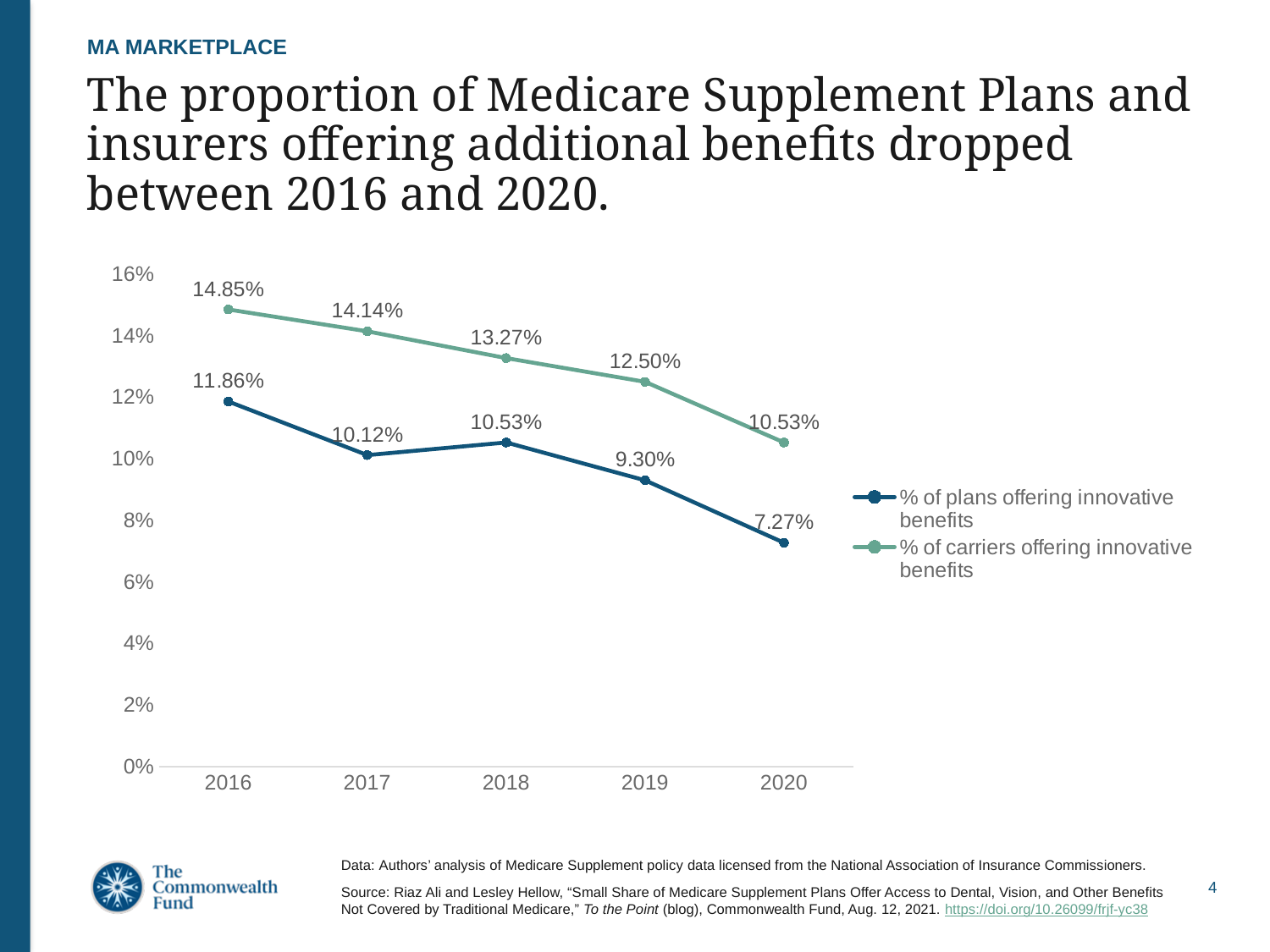
What percentage of plans offered innovative benefits in 2020? 7.27% Which was larger in 2018: the % of plans or the % of carriers offering innovative benefits? % of carriers offering innovative benefits How many years are shown on the x axis? 5 By how much did the % of plans offering innovative benefits fall from 2016 to 2020? 4.59% How many series does the legend list? 2 What kind of chart is shown on the slide? Line chart In which year was the % of carriers offering innovative benefits highest? 2016 What is the difference between the % of carriers and the % of plans offering innovative benefits in 2020? 3.26% What percentage of carriers offered innovative benefits in 2019? 12.50% What percentage of plans offered innovative benefits in 2016? 11.86% Does the % of carriers offering innovative benefits rise or fall from 2016 to 2020? Fall In which year was the % of plans offering innovative benefits lowest? 2020